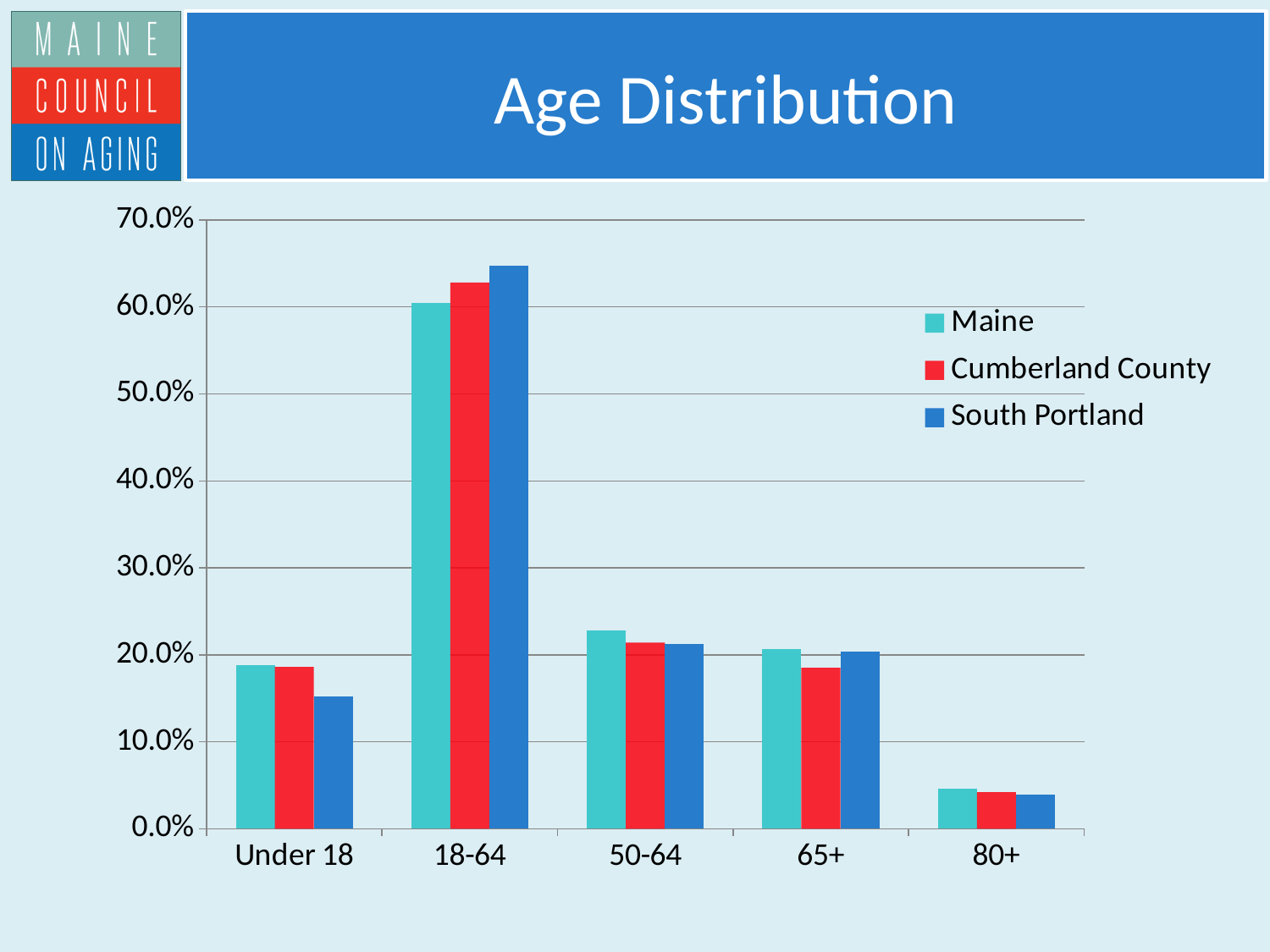
What is the title of the slide? Age Distribution Is the South Portland value for 18-64 greater or less than 60.0%? greater For the Maine series, which age category has the highest value? 18-64 Is the Cumberland County value for 80+ greater or less than 10.0%? less For the South Portland series, which age category has the lowest value? 80+ In the 18-64 category, which is larger: Maine or South Portland? South Portland How many series does the legend list? 3 How many age categories are shown on the x axis? 5 Is the Maine value for Under 18 greater or less than 20.0%? less What kind of chart is shown on the slide? Bar chart In the Under 18 category, which is larger: Maine or South Portland? Maine